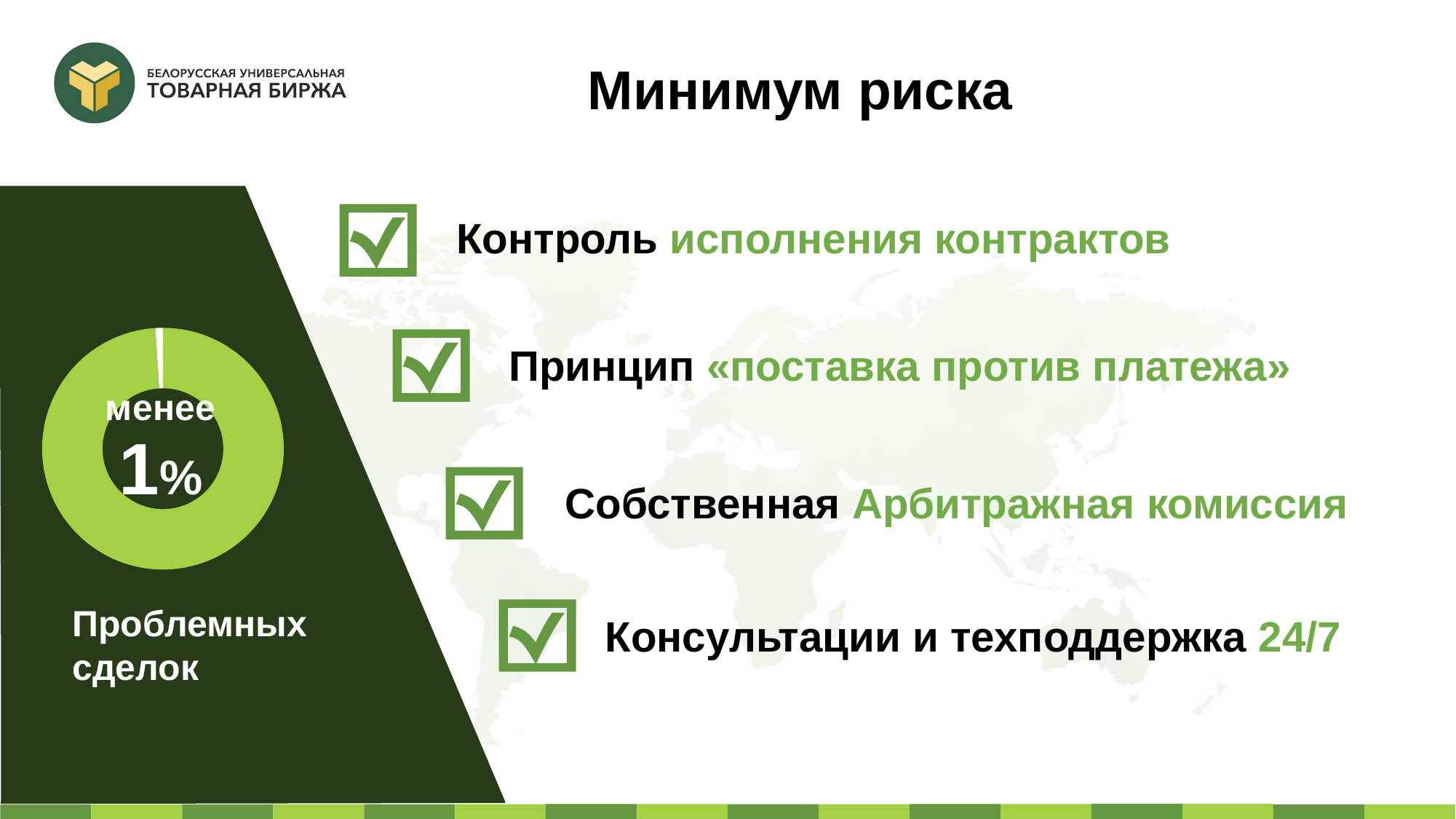
What text is printed in the centre of the doughnut chart? менее 1% What kind of chart is shown on the left of the slide? Doughnut chart Is the share of problem deals shown in the doughnut chart greater or less than 1%? less What colour is the large segment of the doughnut chart? Green What is the label printed below the doughnut chart? Проблемных сделок How many segments does the doughnut chart have? 2 What share of deals does the doughnut chart show as problematic? менее 1%